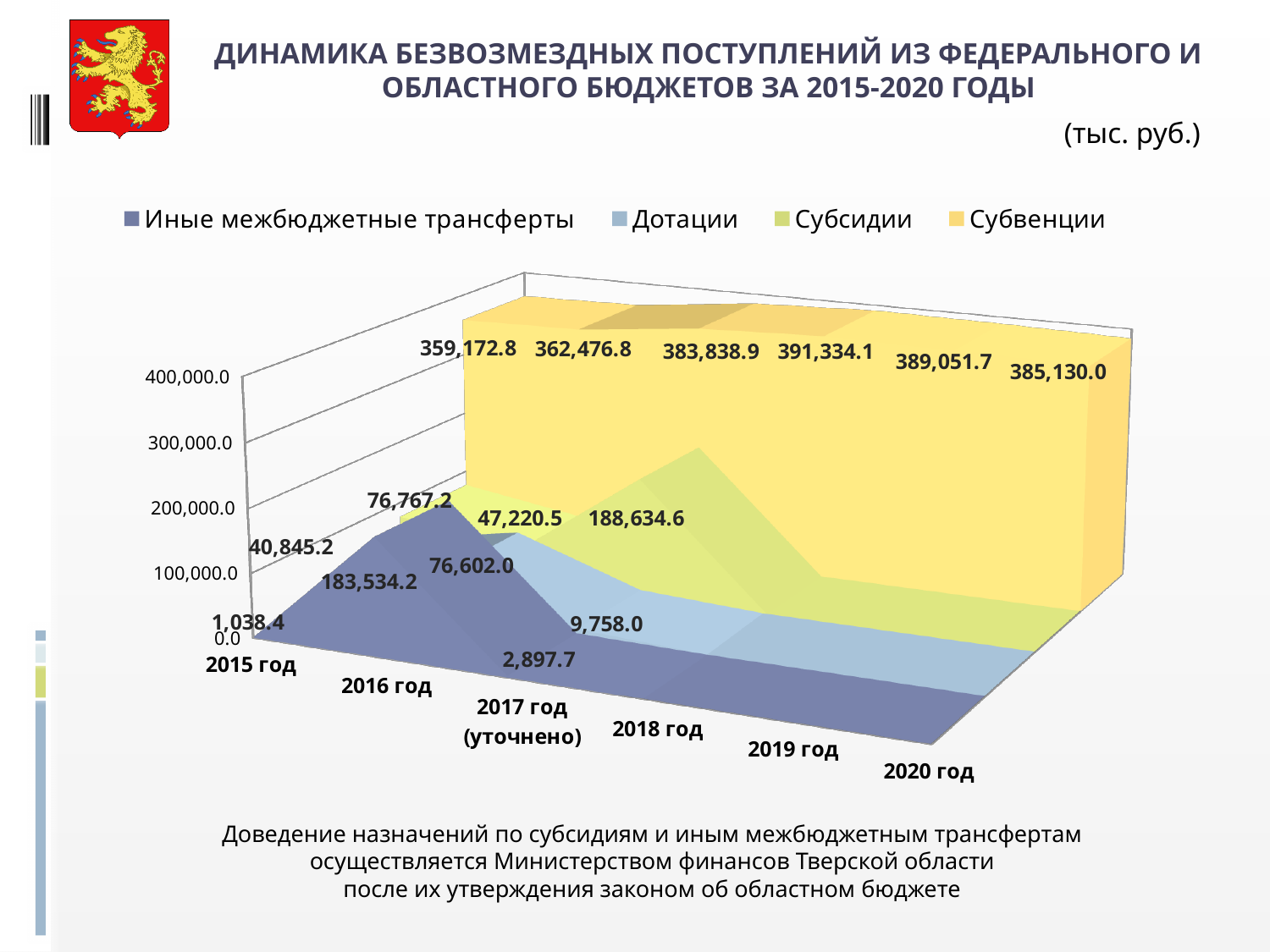
What kind of chart is shown on the slide? area chart How many year categories are shown along the x axis? 6 What is the value of Субвенции for 2015 год? 359,172.8 Which is larger, the Субвенции value for 2019 год or for 2020 год? 2019 год How many series does the legend list? 4 In which year is the value of Субвенции lowest? 2015 год What is the difference between the Субвенции values for 2018 год and 2015 год? 32,161.3 What is the value of Субвенции for 2018 год? 391,334.1 What unit of measurement is stated for the chart values? тыс. руб. In which year is the value of Субвенции highest? 2018 год What is the value of Субвенции for 2020 год? 385,130.0 Do the Субвенции values rise or fall from 2015 год to 2018 год? rise